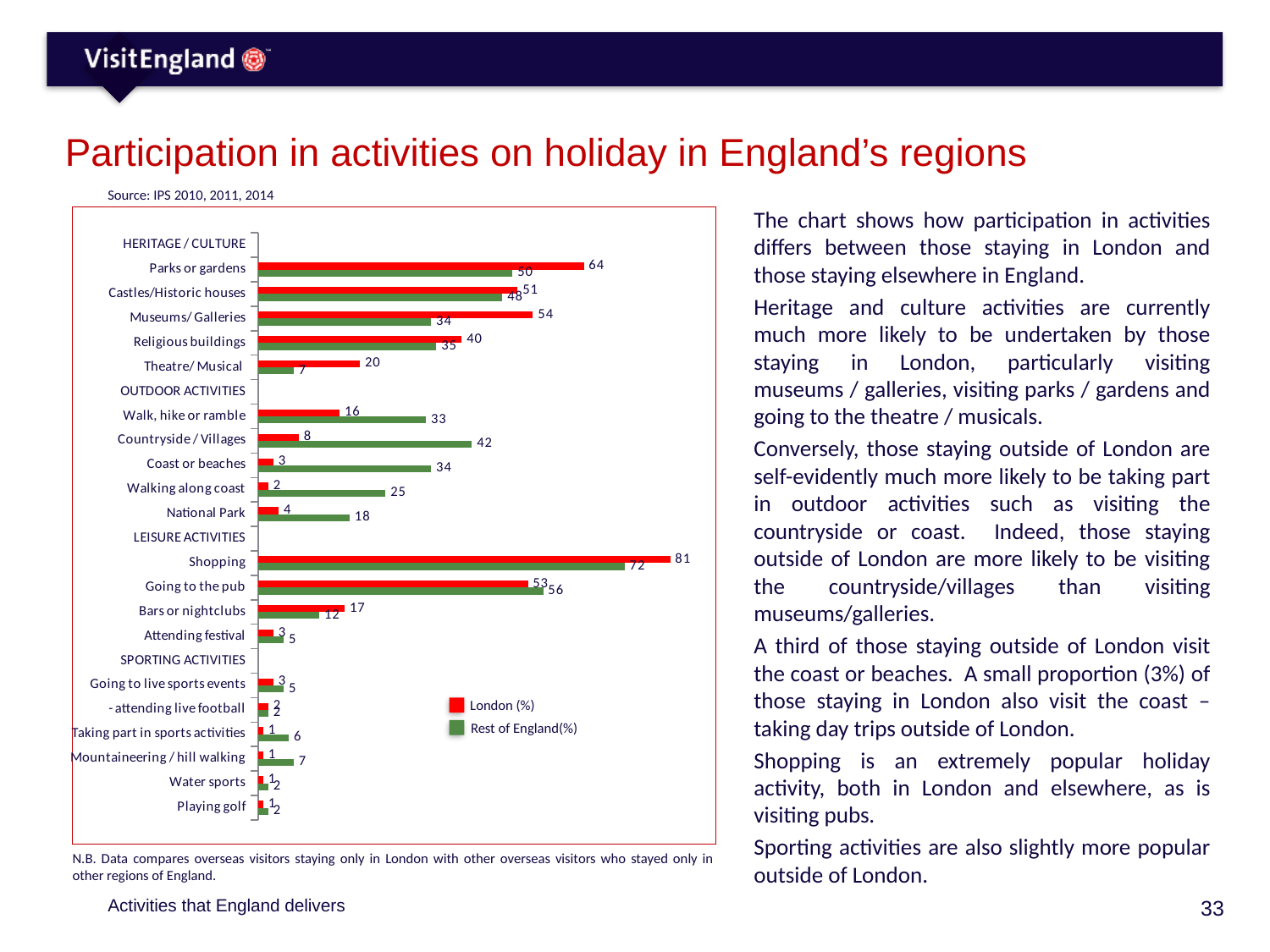
What is the Rest of England (%) value for Coast or beaches? 34 What type of chart is shown on the slide? Bar chart For Going to the pub, which is larger: the London (%) value or the Rest of England (%) value? Rest of England (%) What is the difference between the London (%) and Rest of England (%) values for Theatre/ Musical? 13 How many series does the legend list? 2 What is the Rest of England (%) value for Countryside / Villages? 42 For Parks or gardens, which is larger: the London (%) value or the Rest of England (%) value? London (%) What is the London (%) value for Shopping? 81 What is the difference between the Rest of England (%) and London (%) values for Walking along coast? 23 Which activity has the highest Rest of England (%) value? Shopping Which activity has the highest London (%) value? Shopping What is the London (%) value for Museums/ Galleries? 54